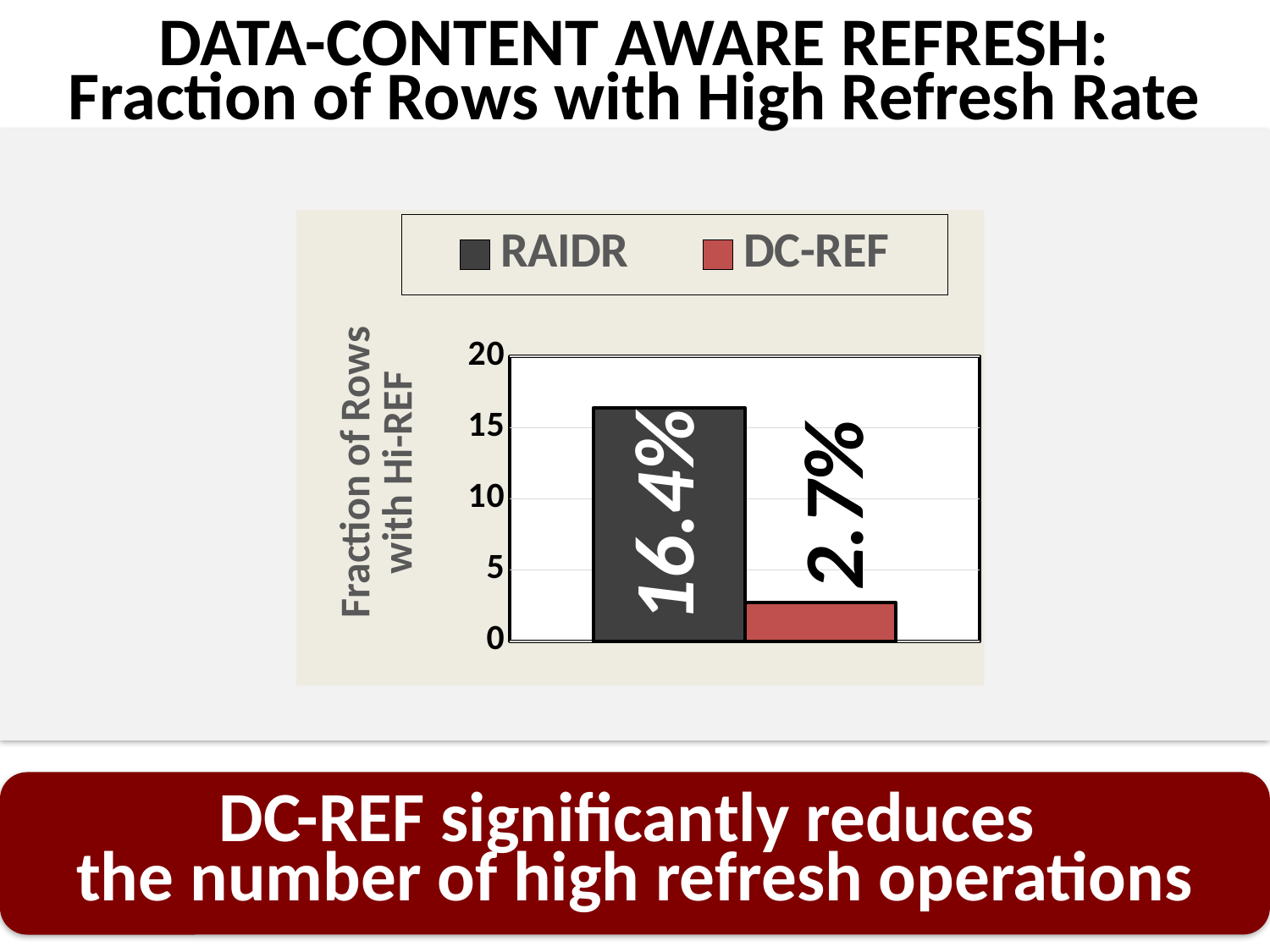
How many series does the legend list? 2 What is the maximum value shown on the y axis? 20 Is the value for DC-REF greater or less than 5? less What is the difference between the RAIDR and DC-REF values? 13.7% What kind of chart is shown on the slide? bar chart What is the fraction of rows with Hi-REF for RAIDR? 16.4% What is the label of the y axis? Fraction of Rows with Hi-REF What colour is the DC-REF bar? red What is the fraction of rows with Hi-REF for DC-REF? 2.7% Is the value for RAIDR greater or less than 15? greater Which series has the lower fraction of rows with Hi-REF? DC-REF Which series has the higher fraction of rows with Hi-REF? RAIDR